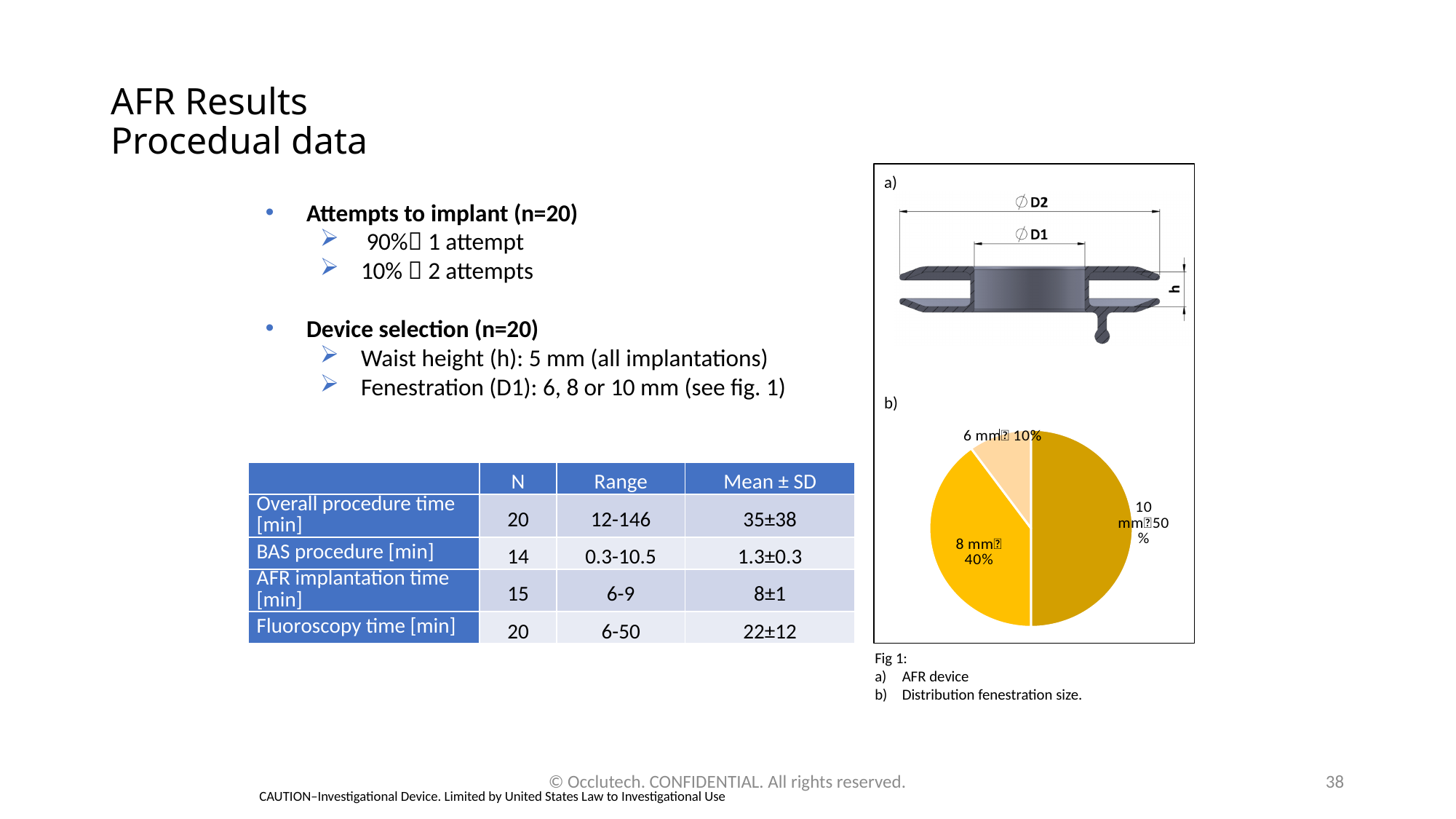
In the pie chart in Fig 1 b), what share of implantations used the 10 mm fenestration? 50% In the pie chart in Fig 1 b), which fenestration size has the smallest share? 6 mm In the pie chart in Fig 1 b), how many slices are there? 3 In the pie chart in Fig 1 b), which fenestration size has the largest share? 10 mm In the pie chart in Fig 1 b), which has the larger share, 10 mm or 8 mm? 10 mm In the pie chart in Fig 1 b), what is the difference in percentage points between the 8 mm and 6 mm shares? 30 In the pie chart in Fig 1 b), what share of implantations used the 6 mm fenestration? 10% What kind of chart is shown in Fig 1 b)? pie chart In the pie chart in Fig 1 b), what is the difference in percentage points between the 10 mm and 8 mm shares? 10 According to the figure caption, what does the pie chart in Fig 1 b) show? Distribution fenestration size In the pie chart in Fig 1 b), what share of implantations used the 8 mm fenestration? 40% In the pie chart in Fig 1 b), which has the larger share, 8 mm or 6 mm? 8 mm